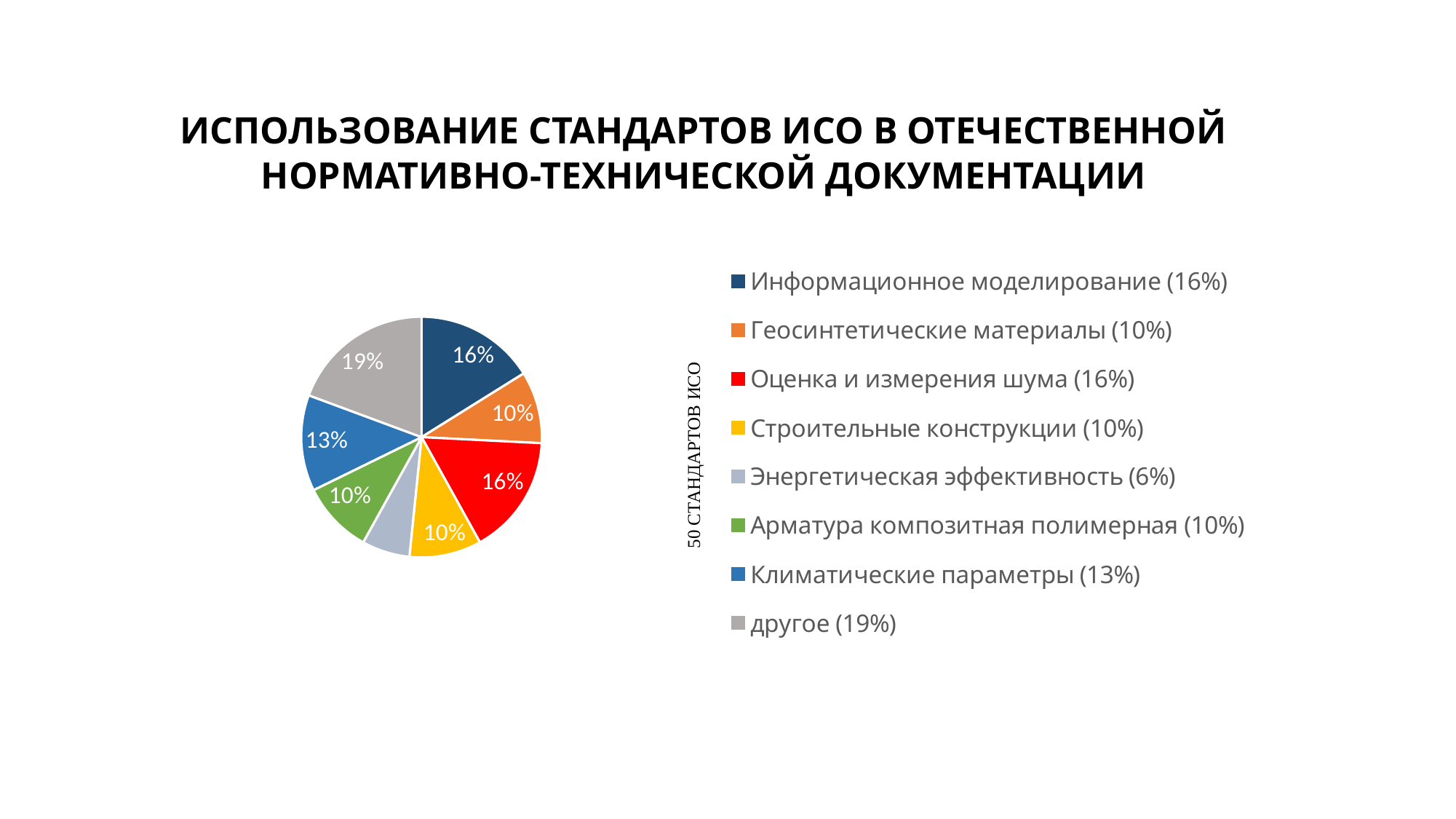
Which is larger, the share for "Оценка и измерения шума" or the share for "Строительные конструкции"? Оценка и измерения шума How many slices does the pie chart have? 8 What is the value shown for "Климатические параметры"? 13% What is the value shown for "другое"? 19% What share of the pie does "Информационное моделирование" represent? 16% What is the value shown for "Энергетическая эффективность"? 6% How many categories in the legend have a share of 10%? 3 What colour is the slice for "Оценка и измерения шума"? red Which category has the largest slice of the pie? другое What is the difference between the share for "другое" and the share for "Климатические параметры"? 6% What kind of chart is shown on the slide? pie chart Which category has the smallest slice of the pie? Энергетическая эффективность